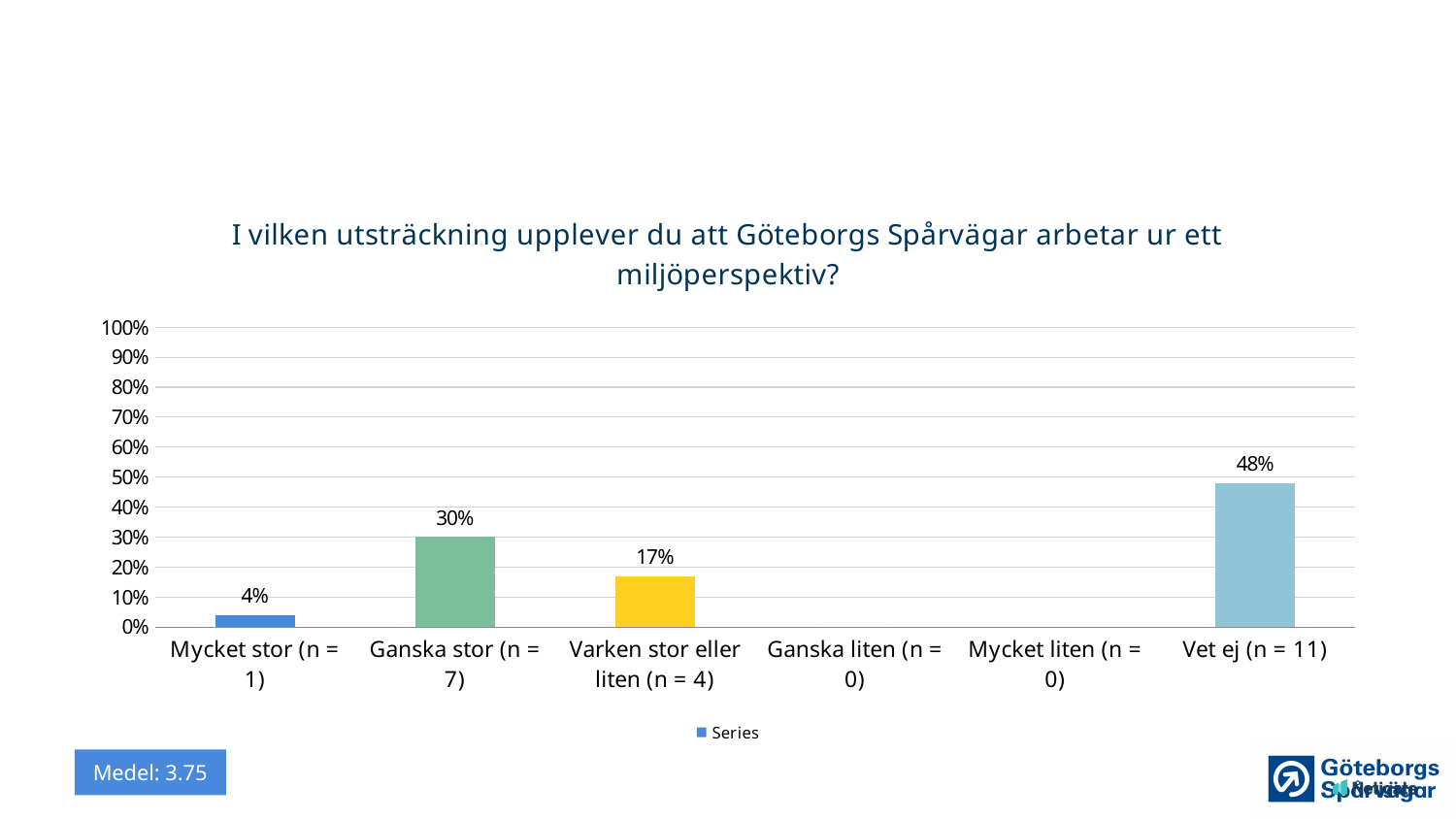
What is the value for "Ganska stor (n = 7)"? 30% What is the value for "Mycket stor (n = 1)"? 4% What kind of chart is shown on the slide? Bar chart What is the value for "Varken stor eller liten (n = 4)"? 17% What is the value for "Vet ej (n = 11)"? 48% What is the difference between the values for "Vet ej (n = 11)" and "Ganska stor (n = 7)"? 18% Which category has the highest value? Vet ej (n = 11) How many categories are shown on the x axis? 6 What value is shown in the "Medel" box at the bottom left of the slide? 3.75 Which is larger, the value for "Ganska stor (n = 7)" or "Varken stor eller liten (n = 4)"? Ganska stor (n = 7) Which category with a visible bar has the lowest value? Mycket stor (n = 1) Is the value for "Vet ej (n = 11)" greater or less than 40%? greater